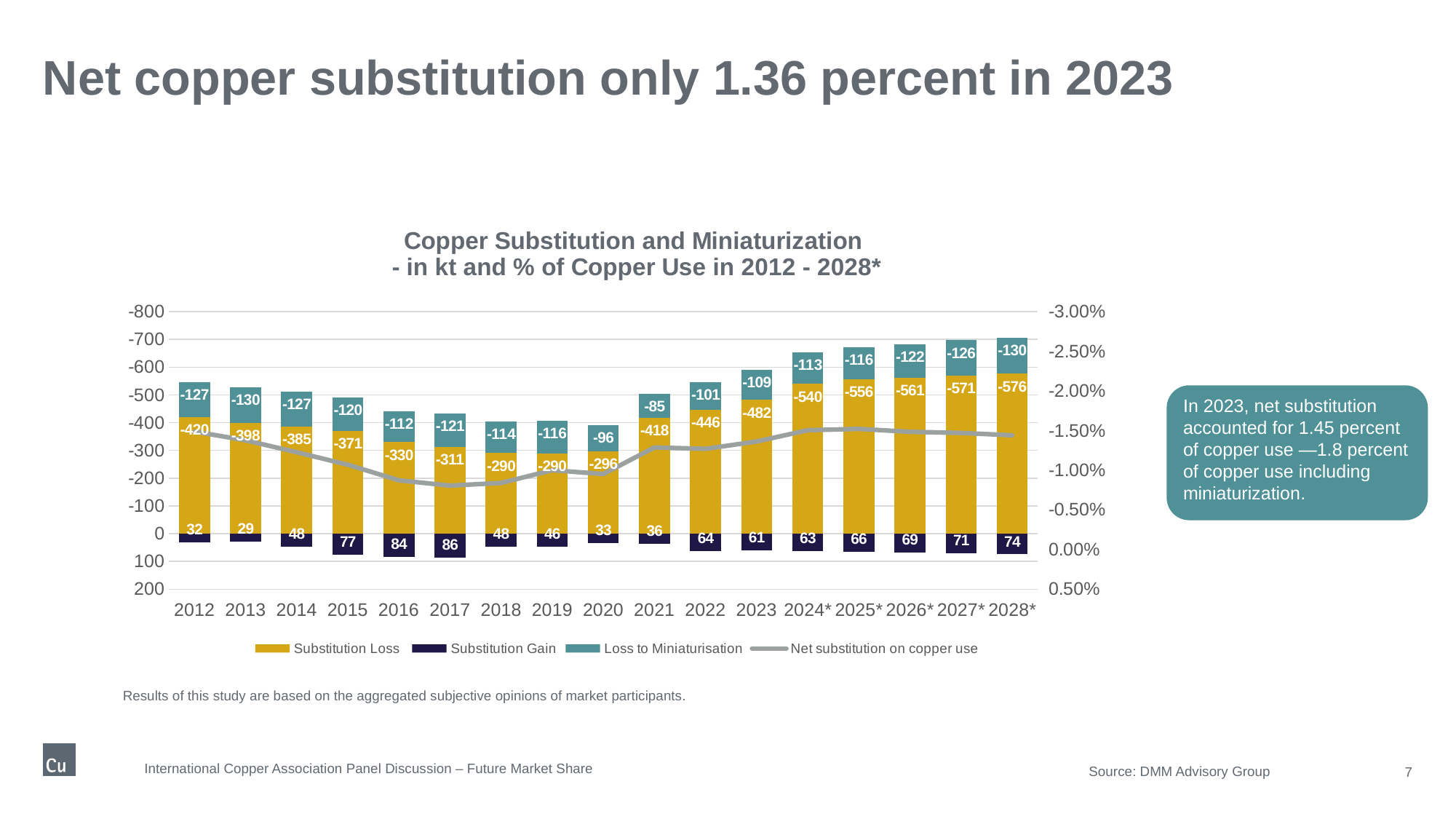
How many years are shown on the x axis? 17 What is the Loss to Miniaturisation value for 2020? -96 What is the difference between the Substitution Loss values for 2023 and 2012? 62 Which year has the highest Substitution Gain value? 2017 What is the Substitution Gain value for 2015? 77 How many series does the legend list? 4 Which year has the lowest Substitution Gain value? 2013 Which year has the smallest Loss to Miniaturisation in magnitude? 2021 What is the combined Substitution Loss and Loss to Miniaturisation for 2023? -591 What is the Substitution Loss value for 2023? -482 What is the Substitution Loss value for 2028*? -576 Which is larger in magnitude, the Substitution Loss for 2016 or for 2021? 2021